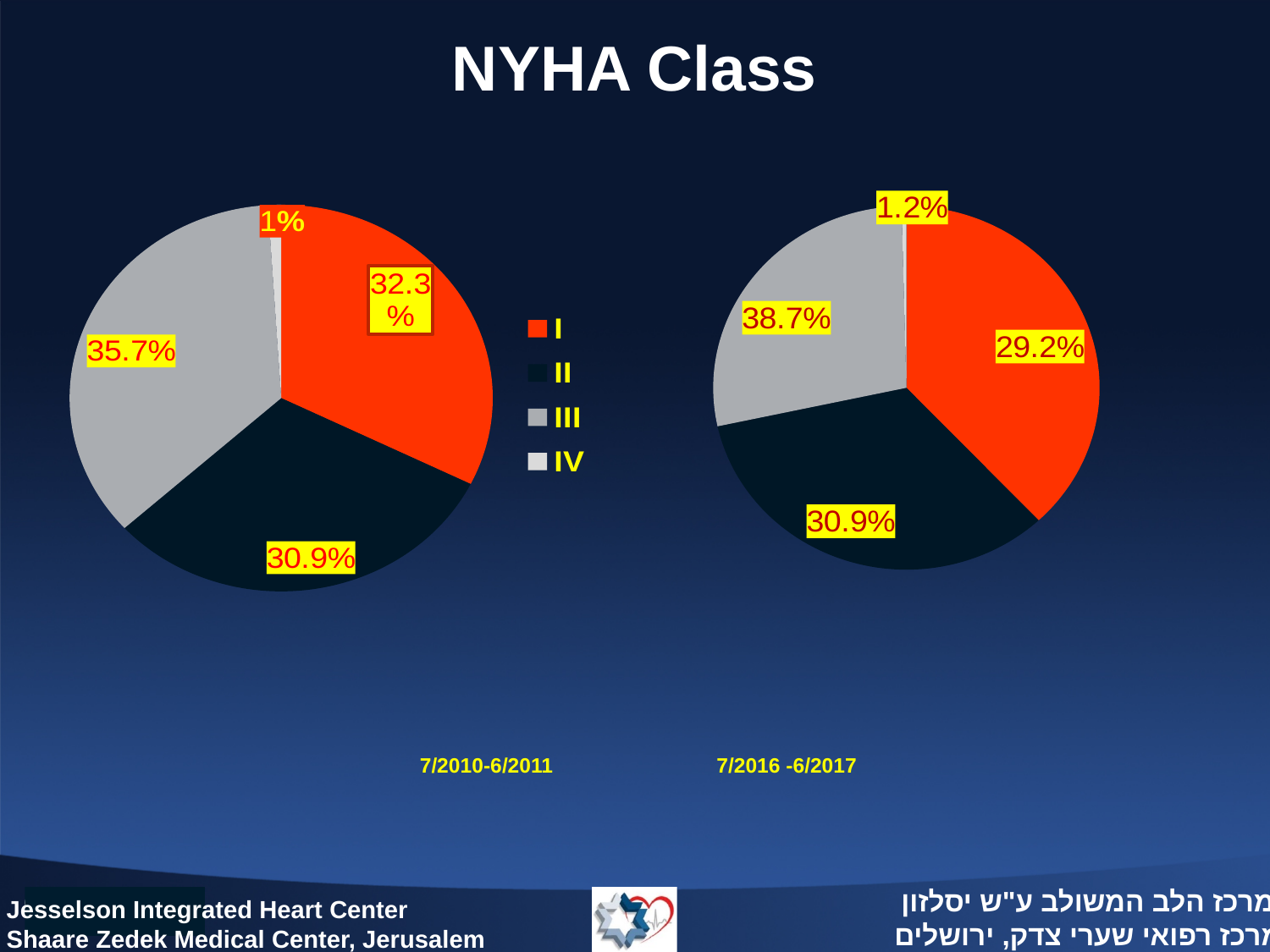
In the 7/2016-6/2017 pie chart, what percentage is shown for NYHA class III? 38.7% In the 7/2010-6/2011 pie chart, which NYHA class has the largest share? III In the 7/2016-6/2017 pie chart, which NYHA class has the smallest share? IV What is the difference between the class III share in the 7/2016-6/2017 pie chart and the class III share in the 7/2010-6/2011 pie chart? 3% How many entries does the legend list? 4 What type of chart is used on this slide? Pie chart In the 7/2010-6/2011 pie chart, what percentage is shown for NYHA class II? 30.9% What is the title of the slide containing the charts? NYHA Class In the 7/2010-6/2011 pie chart, what percentage is shown for NYHA class I? 32.3% In the 7/2016-6/2017 pie chart, what percentage is shown for NYHA class IV? 1.2% How many slices does the 7/2016-6/2017 pie chart have? 4